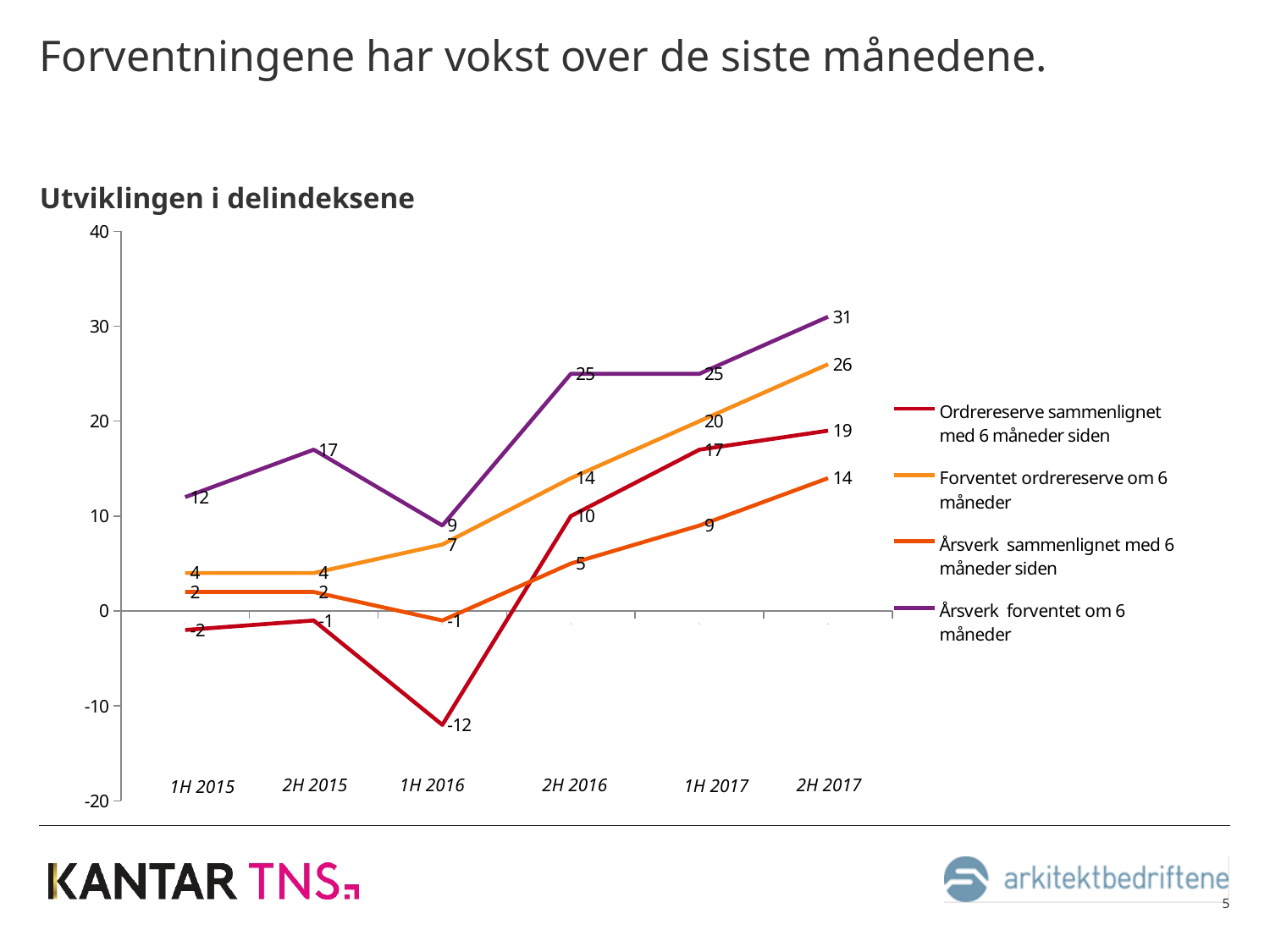
What kind of chart is shown on the slide? Line chart What is the title of the chart? Utviklingen i delindeksene How many series does the legend list? 4 What is the value of 'Ordrereserve sammenlignet med 6 måneder siden' in 1H 2016? -12 Which series has the highest value in 2H 2017? Årsverk forventet om 6 måneder What is the value of 'Årsverk forventet om 6 måneder' in 2H 2017? 31 What is the difference between 'Forventet ordrereserve om 6 måneder' and 'Årsverk sammenlignet med 6 måneder siden' in 2H 2017? 12 Does 'Årsverk sammenlignet med 6 måneder siden' rise or fall from 1H 2016 to 2H 2017? Rise How many time periods are shown on the x axis? 6 What is the value of 'Forventet ordrereserve om 6 måneder' in 1H 2017? 20 In which period does 'Ordrereserve sammenlignet med 6 måneder siden' reach its lowest value? 1H 2016 Which is larger in 2H 2016: 'Ordrereserve sammenlignet med 6 måneder siden' or 'Forventet ordrereserve om 6 måneder'? Forventet ordrereserve om 6 måneder